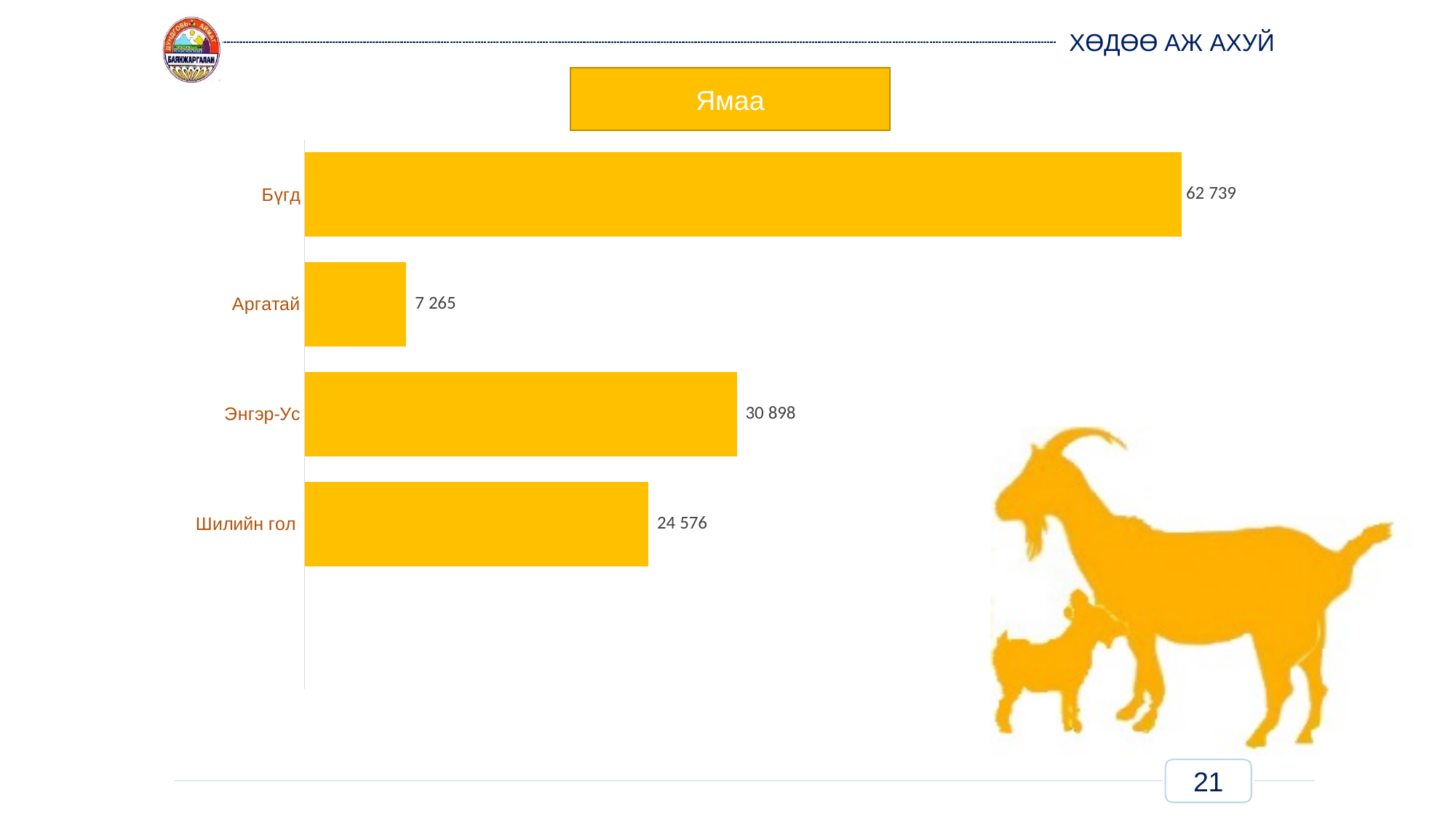
What is the value for Аргатай? 7 265 What is the title of the chart? Ямаа What is the difference between the values for Энгэр-Ус and Шилийн гол? 6 322 Which category has the highest value? Бүгд What is the value for Бүгд? 62 739 Which is larger, the value for Энгэр-Ус or the value for Шилийн гол? Энгэр-Ус Which category has the lowest value? Аргатай What is the value for Энгэр-Ус? 30 898 What is the value for Шилийн гол? 24 576 What kind of chart is shown on the slide? bar chart How many categories are shown in the chart? 4 What is the difference between the values for Энгэр-Ус and Аргатай? 23 633